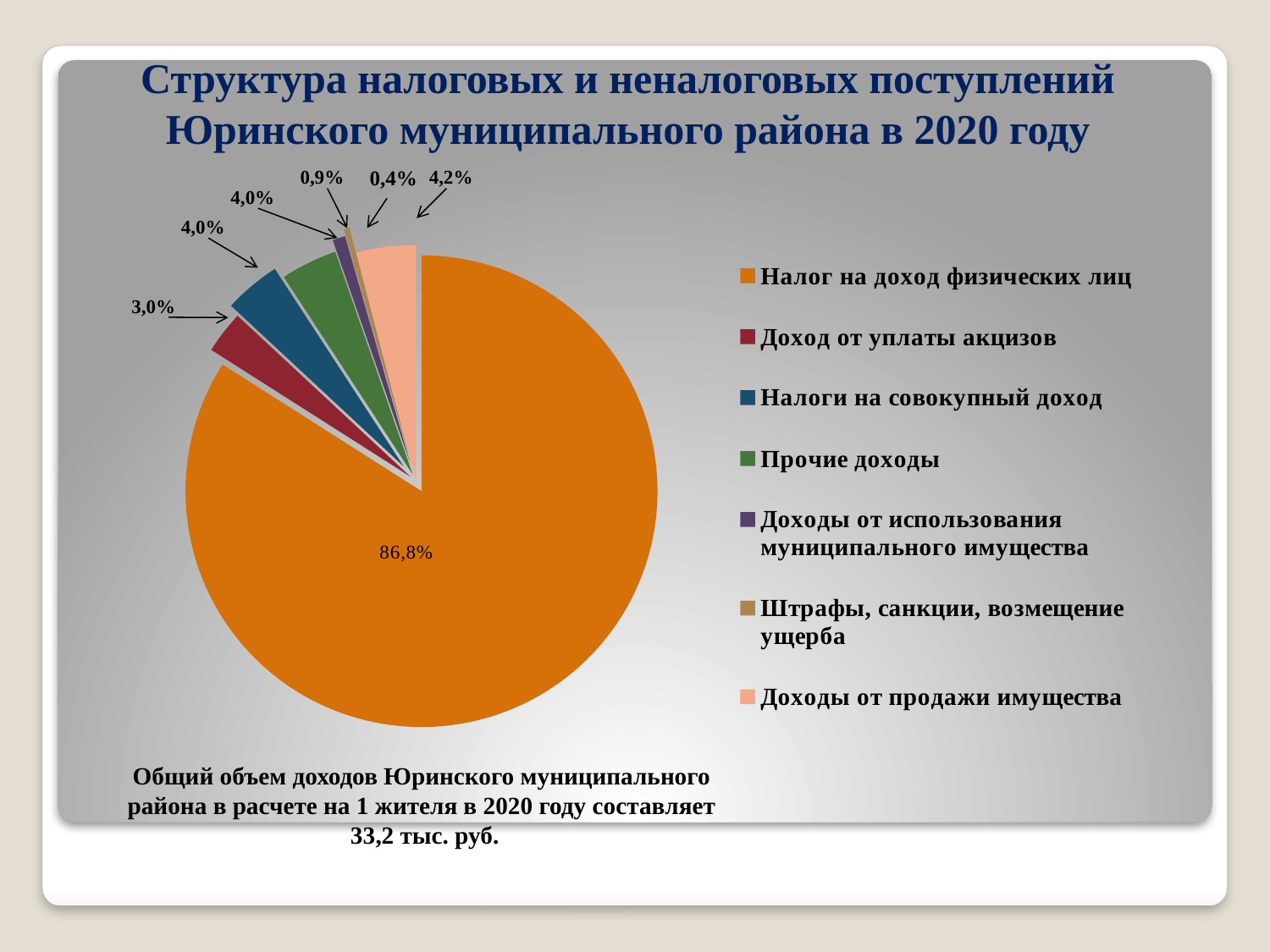
Which is larger: the share for "Доходы от продажи имущества" or the share for "Доход от уплаты акцизов"? Доходы от продажи имущества What share of the pie does "Доход от уплаты акцизов" have? 3,0% Which category has the largest share of the pie? Налог на доход физических лиц What is the difference in percentage points between the share for "Налог на доход физических лиц" and the share for "Прочие доходы"? 82,8 What share of the pie does "Штрафы, санкции, возмещение ущерба" have? 0,4% Which category has the smallest share of the pie? Штрафы, санкции, возмещение ущерба What share of the pie does "Доходы от продажи имущества" have? 4,2% How many categories does the legend list? 7 What share of the pie does "Доходы от использования муниципального имущества" have? 0,9% What colour is the slice for "Налог на доход физических лиц"? orange What share of the pie does "Налог на доход физических лиц" have? 86,8% What type of chart is shown on the slide? pie chart